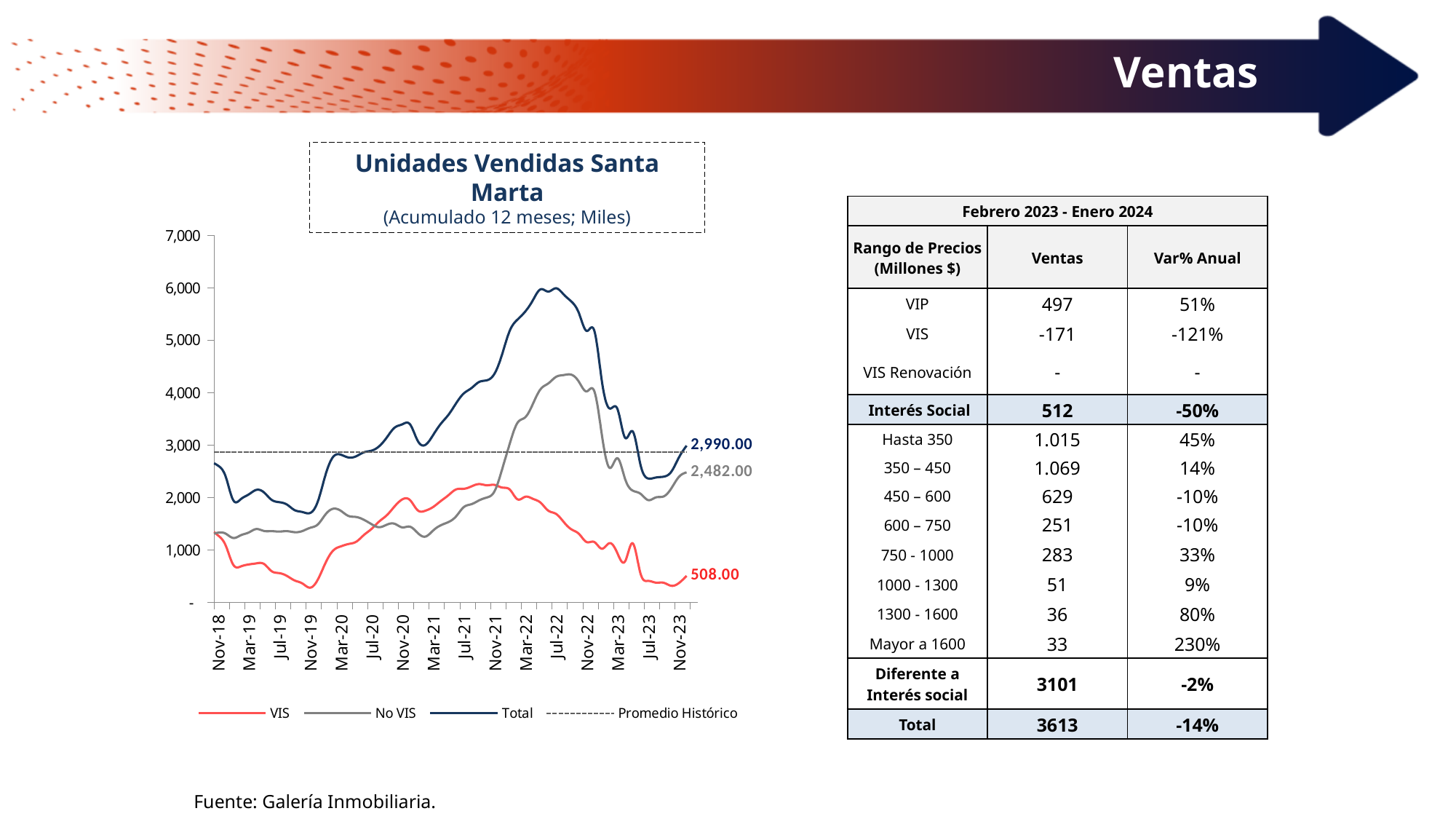
Does the VIS series rise or fall between Nov-21 and Nov-23? fall Is the value of the VIS series at Nov-19 greater or less than 1,000? less What is the final labelled value of the Total series in the Unidades Vendidas Santa Marta chart? 2,990.00 What kind of chart is Unidades Vendidas Santa Marta? Line chart Which series has the highest final labelled value in the chart? Total What is the difference between the final labelled values of the No VIS and VIS series? 1,974.00 At the end of the chart, which series has the larger value: No VIS or VIS? No VIS What is the difference between the final labelled values of the Total and No VIS series? 508.00 Is the peak value of the Total series around Jul-22 greater or less than 5,000? greater How many entries does the chart legend list? 4 What is the final labelled value of the VIS series in the chart? 508.00 What is the final labelled value of the No VIS series in the chart? 2,482.00